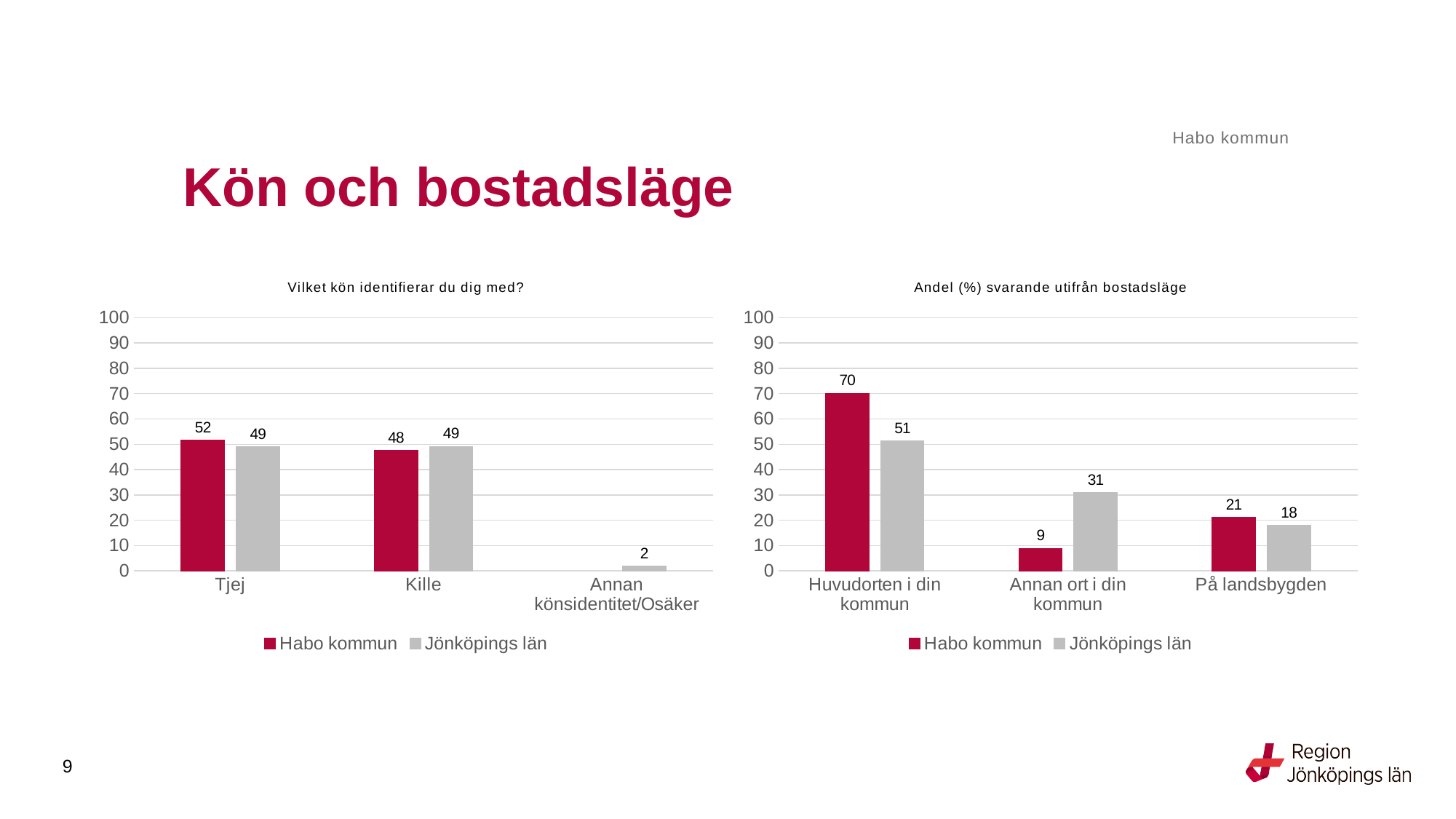
In the chart 'Andel (%) svarande utifrån bostadsläge', which category has the lowest value for Habo kommun? Annan ort i din kommun In the chart 'Andel (%) svarande utifrån bostadsläge', what is the value for Habo kommun for Huvudorten i din kommun? 70 In the chart 'Vilket kön identifierar du dig med?', how many categories are shown on the x axis? 3 How many series does the legend of the chart 'Andel (%) svarande utifrån bostadsläge' list? 2 In the chart 'Andel (%) svarande utifrån bostadsläge', what is the difference between Habo kommun and Jönköpings län for Huvudorten i din kommun? 19 In the chart 'Vilket kön identifierar du dig med?', what is the value for Jönköpings län for Annan könsidentitet/Osäker? 2 In the chart 'Andel (%) svarande utifrån bostadsläge', which is larger for På landsbygden: Habo kommun or Jönköpings län? Habo kommun In the chart 'Andel (%) svarande utifrån bostadsläge', what is the value for Jönköpings län for Annan ort i din kommun? 31 In the chart 'Vilket kön identifierar du dig med?', what is the value for Habo kommun for Tjej? 52 In the chart 'Andel (%) svarande utifrån bostadsläge', which category has the highest value for Habo kommun? Huvudorten i din kommun In the chart 'Vilket kön identifierar du dig med?', what is the value for Jönköpings län for Kille? 49 In the chart 'Vilket kön identifierar du dig med?', what is the difference between Habo kommun and Jönköpings län for Tjej? 3